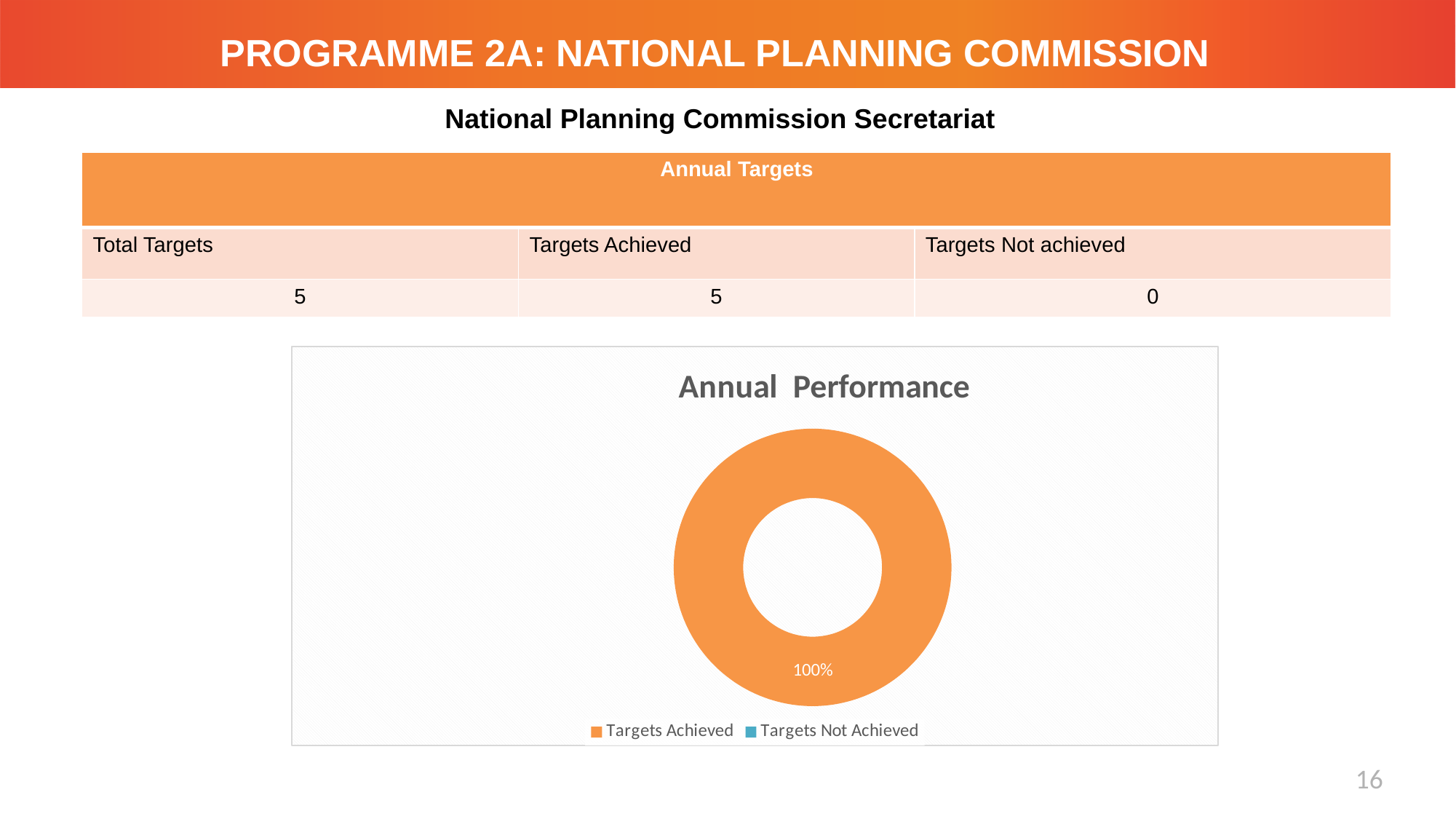
How many entries does the chart legend list? 2 Which is larger in the chart, Targets Achieved or Targets Not Achieved? Targets Achieved What share of the doughnut chart is labelled for Targets Achieved? 100% Which legend entry has no visible slice in the doughnut chart? Targets Not Achieved What kind of chart is shown on the slide? doughnut chart Which category makes up the whole of the doughnut chart? Targets Achieved What percentage value is printed as a data label on the doughnut chart? 100% What is the title of the chart? Annual Performance What colour represents Targets Achieved in the chart legend? orange